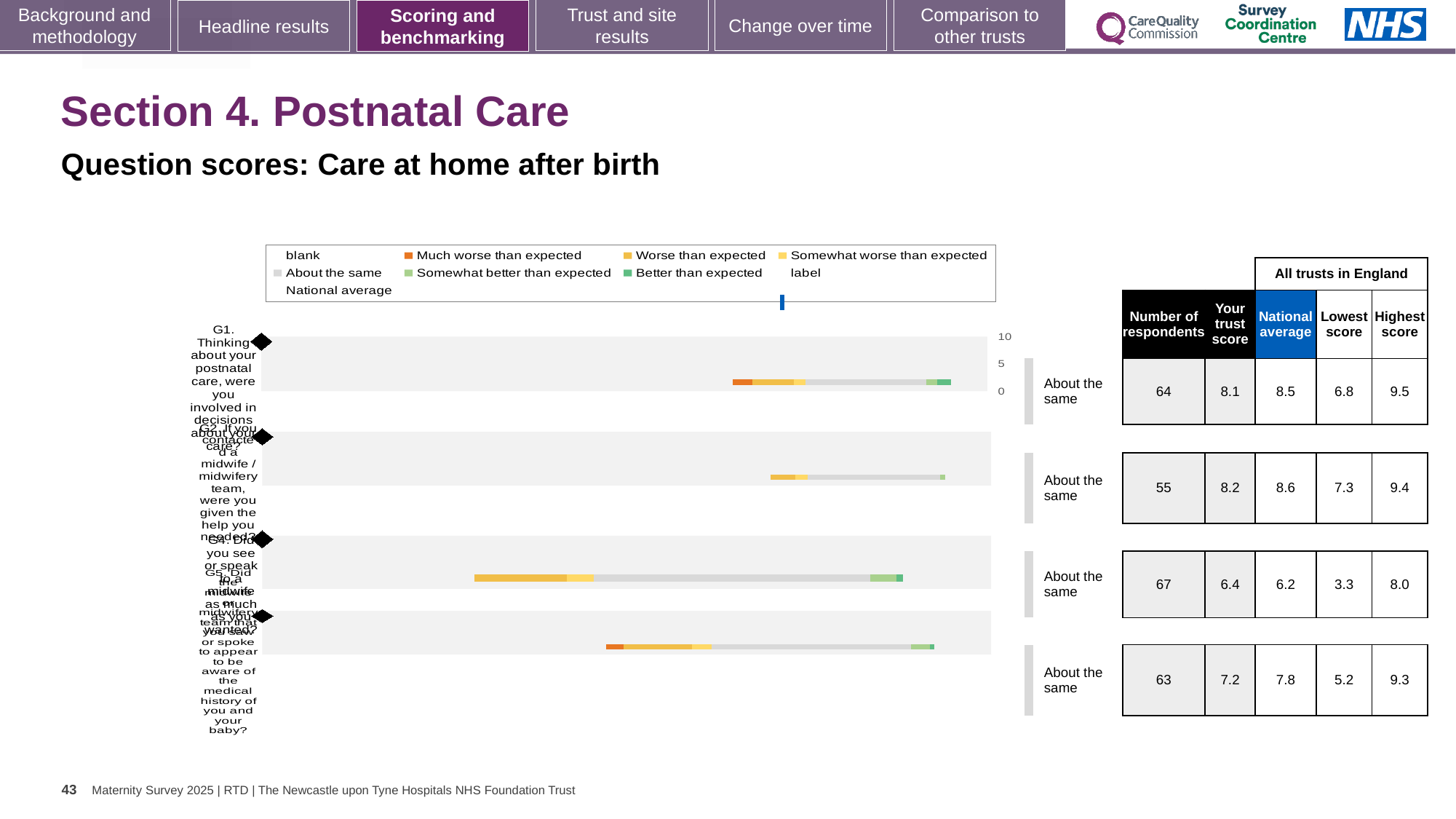
What benchmark category is shown next to each of the four questions? About the same How many questions (bars) are plotted in the chart? 4 What is the difference between the national average and the trust score for question G1? 0.4 What is the highest score across all trusts in England for question G2? 9.4 What is the national average for question G5? 7.8 For question G2, which is larger: the trust score or the national average? National average What is the number of respondents for question G1? 64 Which question has the lowest 'Lowest score' among all trusts in England? G4 What is the difference between the highest score and the lowest score for question G5? 4.1 Which question has the highest 'Your trust score'? G2 What kind of chart is used to show the question scores for care at home after birth? Bar chart What is the trust's score for question G4? 6.4